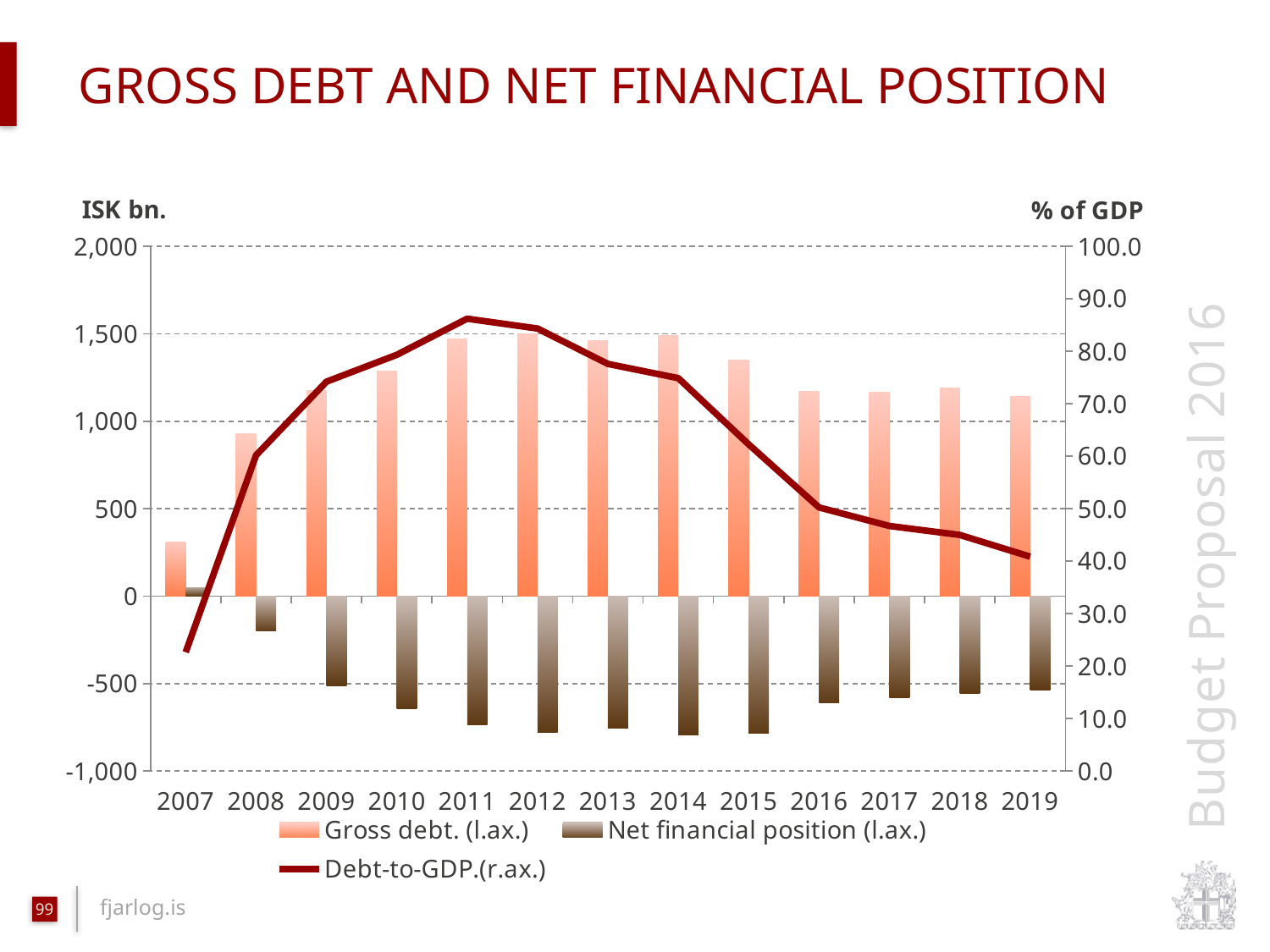
Is the Debt-to-GDP ratio for 2011 greater or less than 80.0% of GDP? greater Does the Debt-to-GDP line rise or fall from 2011 to 2019? fall Is the Gross debt for 2015 greater or less than 1,000 ISK bn? greater In which year is the Debt-to-GDP ratio lowest? 2007 How many series does the legend list? 3 Which year has the lowest Gross debt? 2007 How many years are shown on the x axis? 13 In which year does the Debt-to-GDP line reach its highest point? 2011 What kind of chart is shown on the slide? Combined bar and line chart Is the Gross debt for 2008 greater or less than 1,000 ISK bn? less Which is larger, the Gross debt in 2012 or the Gross debt in 2016? 2012